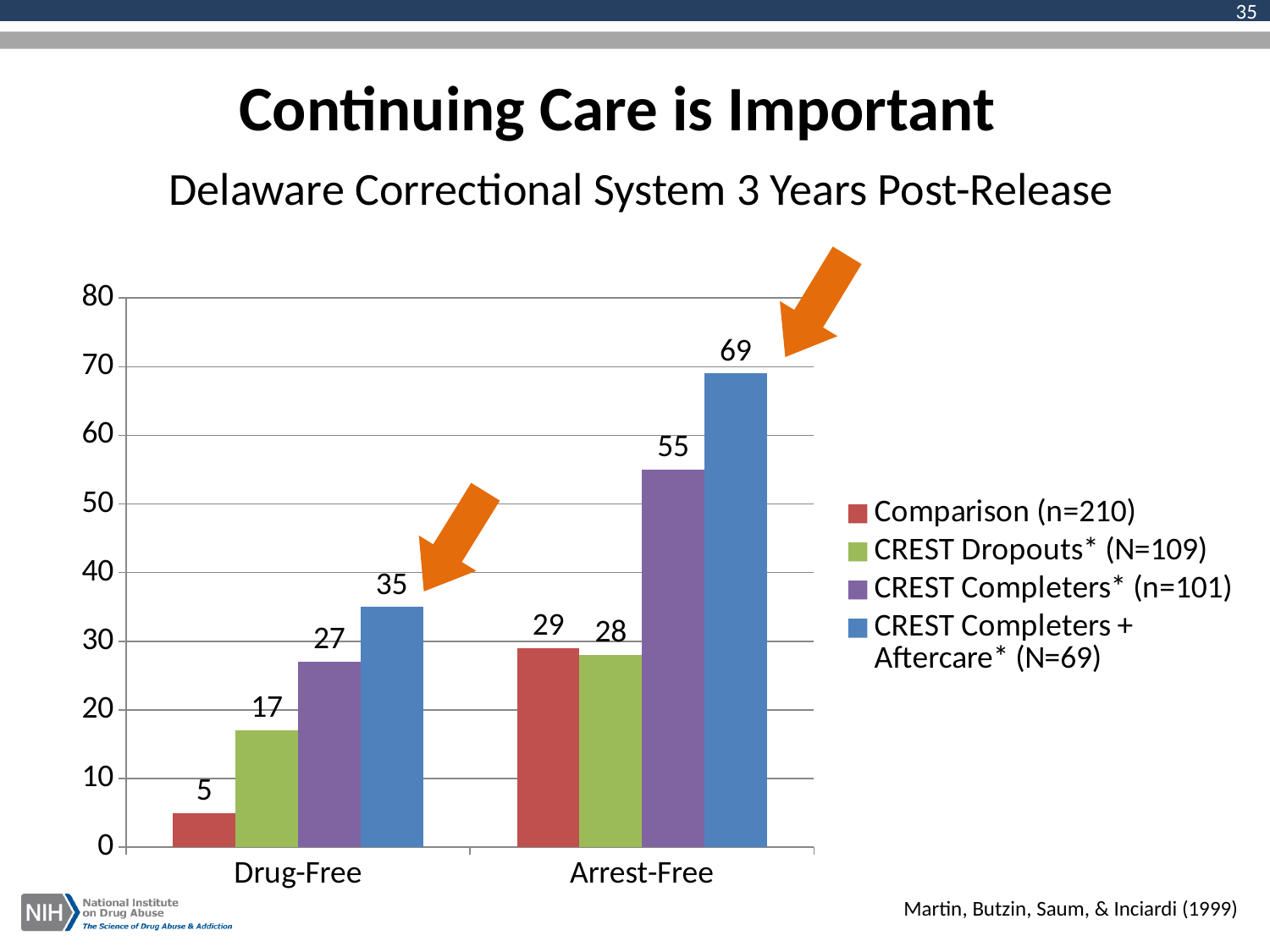
Is the value for CREST Completers + Aftercare* (N=69) in the Arrest-Free category greater or less than 60? greater Which series has the lowest value in the Drug-Free category? Comparison (n=210) Which is larger: the CREST Completers* (n=101) value for Drug-Free or the CREST Completers* (n=101) value for Arrest-Free? Arrest-Free How many categories are shown on the x axis? 2 How many series does the legend list? 4 What is the value for CREST Completers + Aftercare* (N=69) in the Drug-Free category? 35 What is the difference between the CREST Completers* (n=101) value and the CREST Dropouts* (N=109) value in the Drug-Free category? 10 What is the difference between the CREST Completers + Aftercare* (N=69) value and the Comparison (n=210) value in the Arrest-Free category? 40 Which series has the highest value in the Arrest-Free category? CREST Completers + Aftercare* (N=69) What kind of chart is shown on the slide? bar chart What is the value for CREST Dropouts* (N=109) in the Drug-Free category? 17 What is the value for Comparison (n=210) in the Arrest-Free category? 29